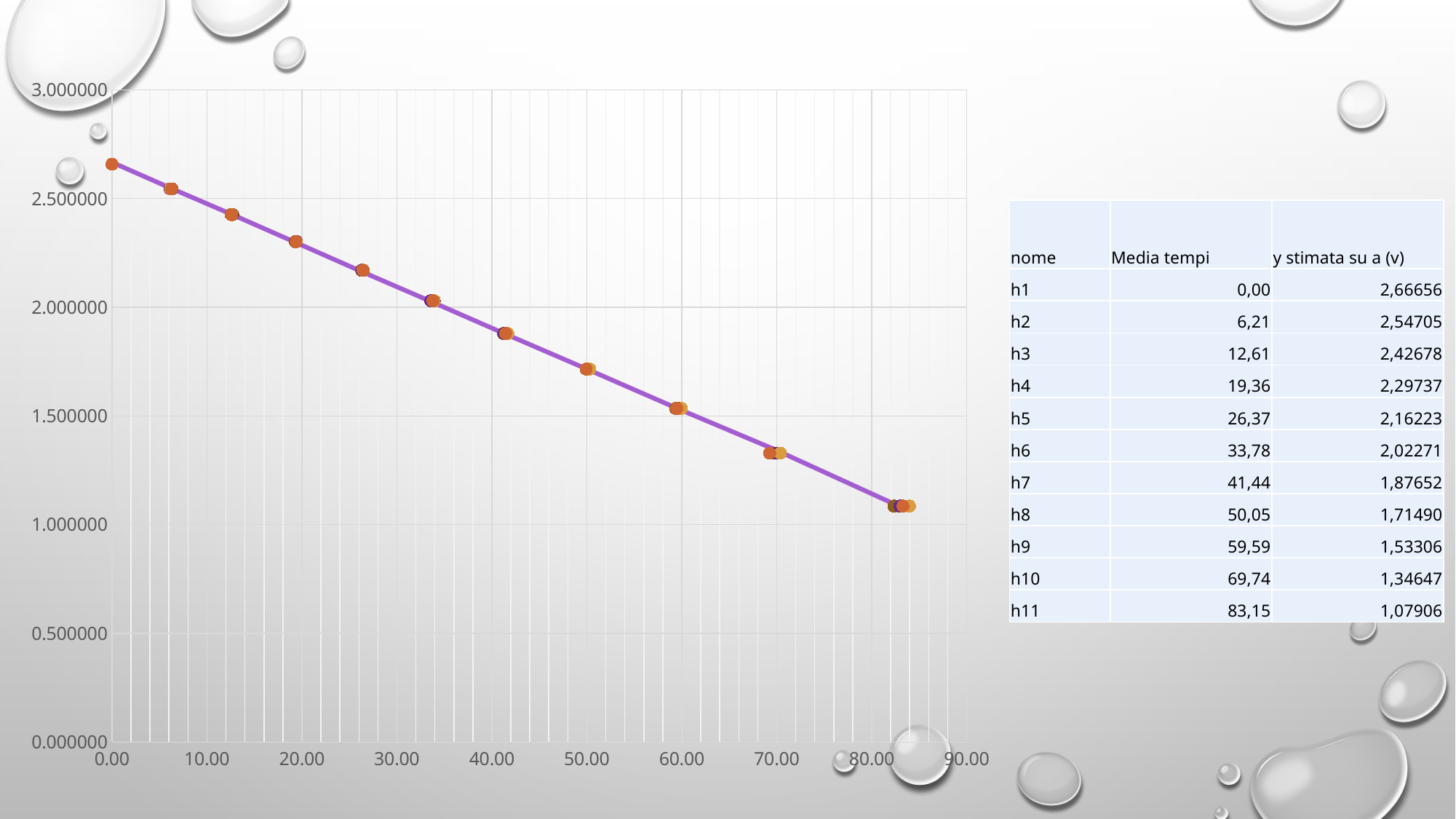
Do the plotted values rise or fall as the x-axis value increases? fall Which is larger: the value of the point at x = 0.00 or the value of the point near x = 83.00? the point at x = 0.00 Is the value of the point near x = 20.00 greater or less than 2.000000? greater Is the value of the point at x = 0.00 greater or less than 2.500000? greater What is the highest value shown on the y-axis of the chart? 3.000000 Is the value of the point near x = 41.00 greater or less than 2.000000? less How many data points are plotted on the chart? 11 What is the highest value shown on the x-axis of the chart? 90.00 What kind of chart is shown on the slide? scatter chart